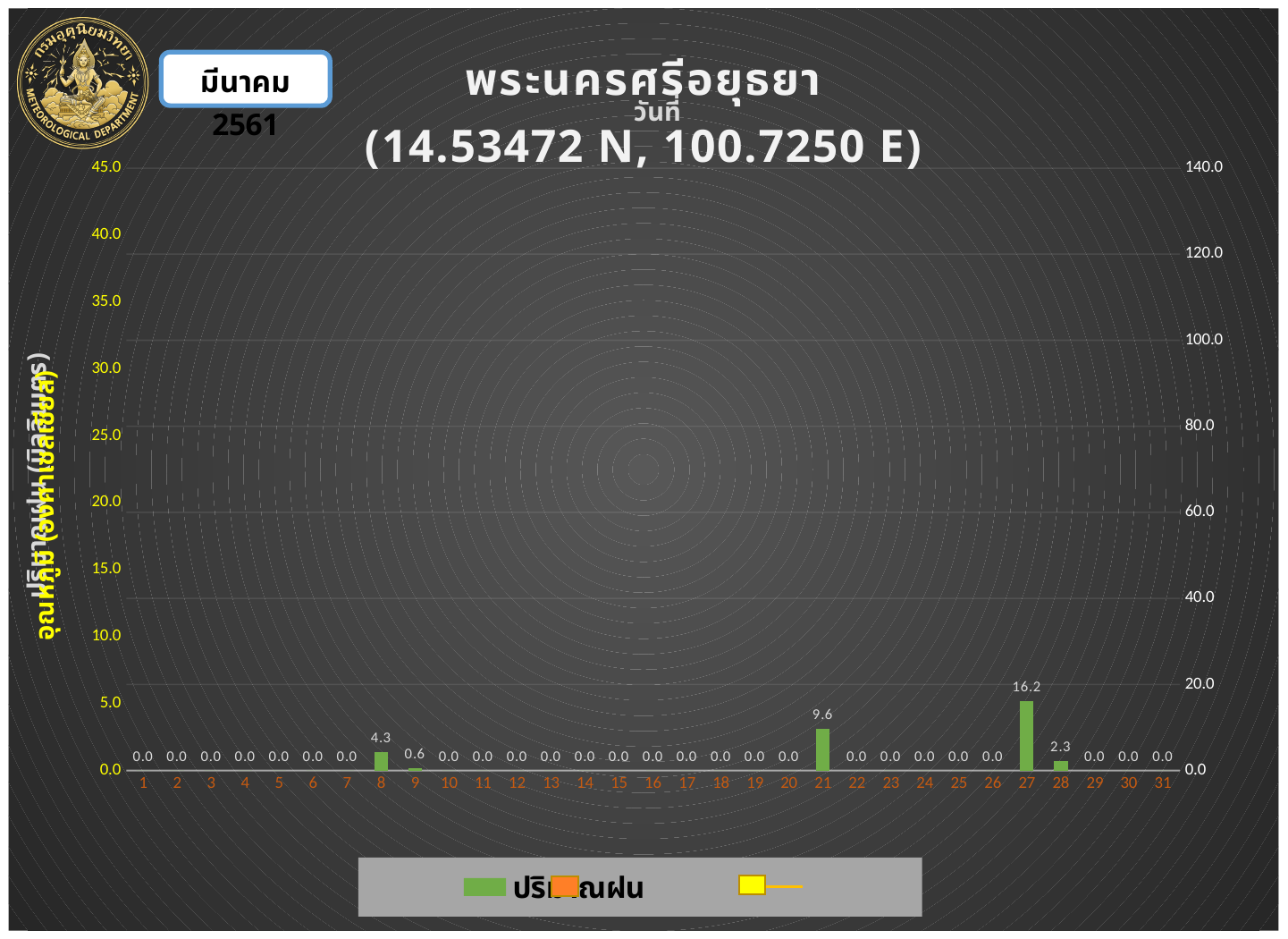
What colour are the rainfall bars in the chart? green What kind of chart is shown on the slide? bar chart What is the rainfall value shown for day 27? 16.2 How many days are shown on the x axis? 31 What is the rainfall value shown for day 28? 2.3 Which is larger, the rainfall value for day 8 or for day 28? day 8 Which day has the highest rainfall value? 27 What is the difference between the rainfall values for day 27 and day 21? 6.6 Is the rainfall value for day 27 greater or less than 15.0? greater What is the rainfall value shown for day 8? 4.3 What is the rainfall value shown for day 21? 9.6 What is the rainfall value shown for day 9? 0.6